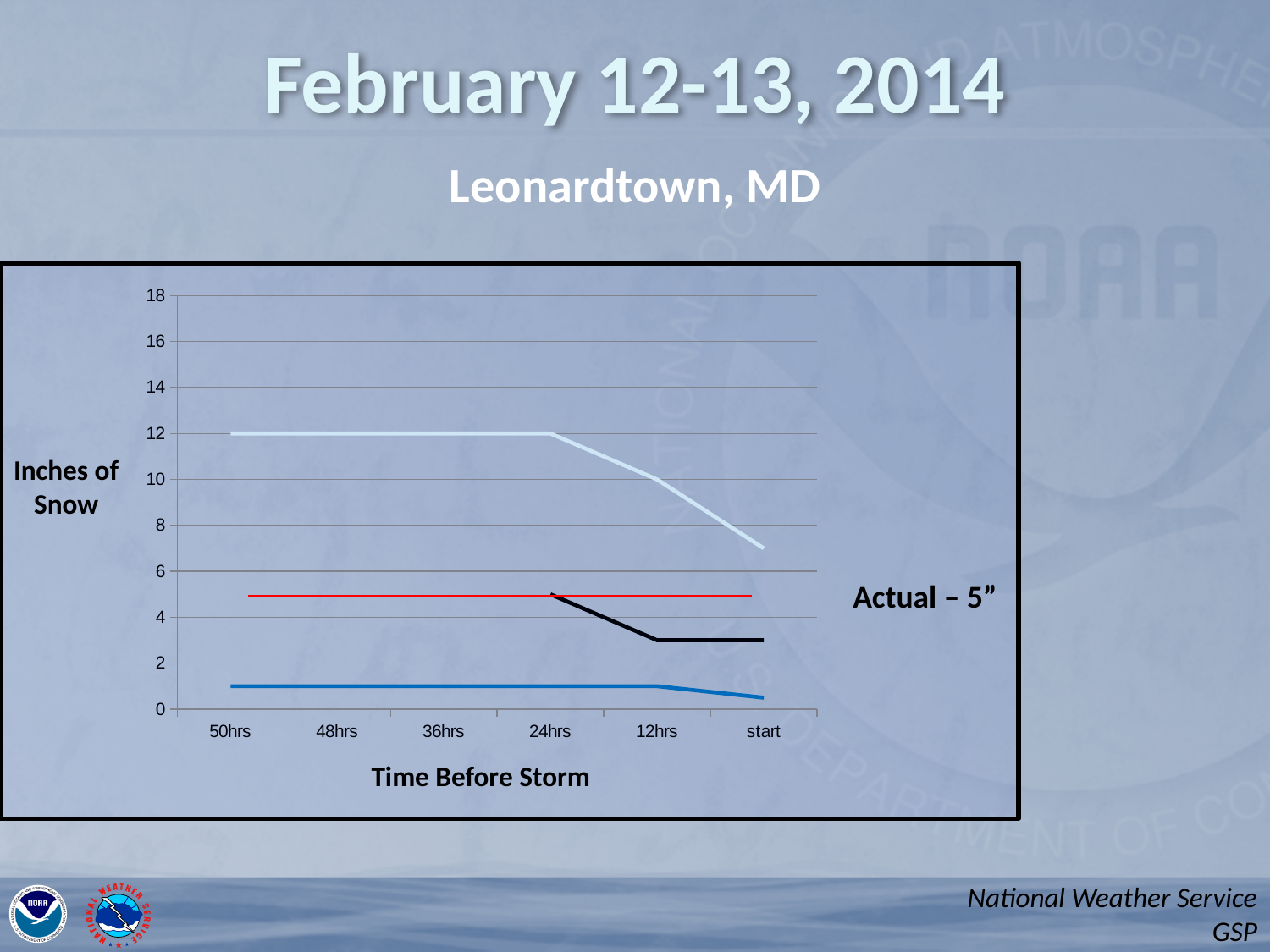
Is the value of the light blue (top) line at start greater or less than 8? less Is the value of the black line at 12hrs greater or less than 4? less How many time points are labelled along the x axis of the chart? 6 Is the value of the black line at 24hrs greater or less than 4? greater What is the title of the x axis of the chart? Time Before Storm What is the value of the light blue (top) line at 12hrs? 10 What actual snowfall amount is annotated next to the chart? 5" Does the light blue (top) line rise or fall between 24hrs and start? fall What kind of chart is shown on the slide? line chart At start, which line has the larger value, the light blue (top) line or the black line? the light blue (top) line What is the value of the light blue (top) line at 50hrs? 12